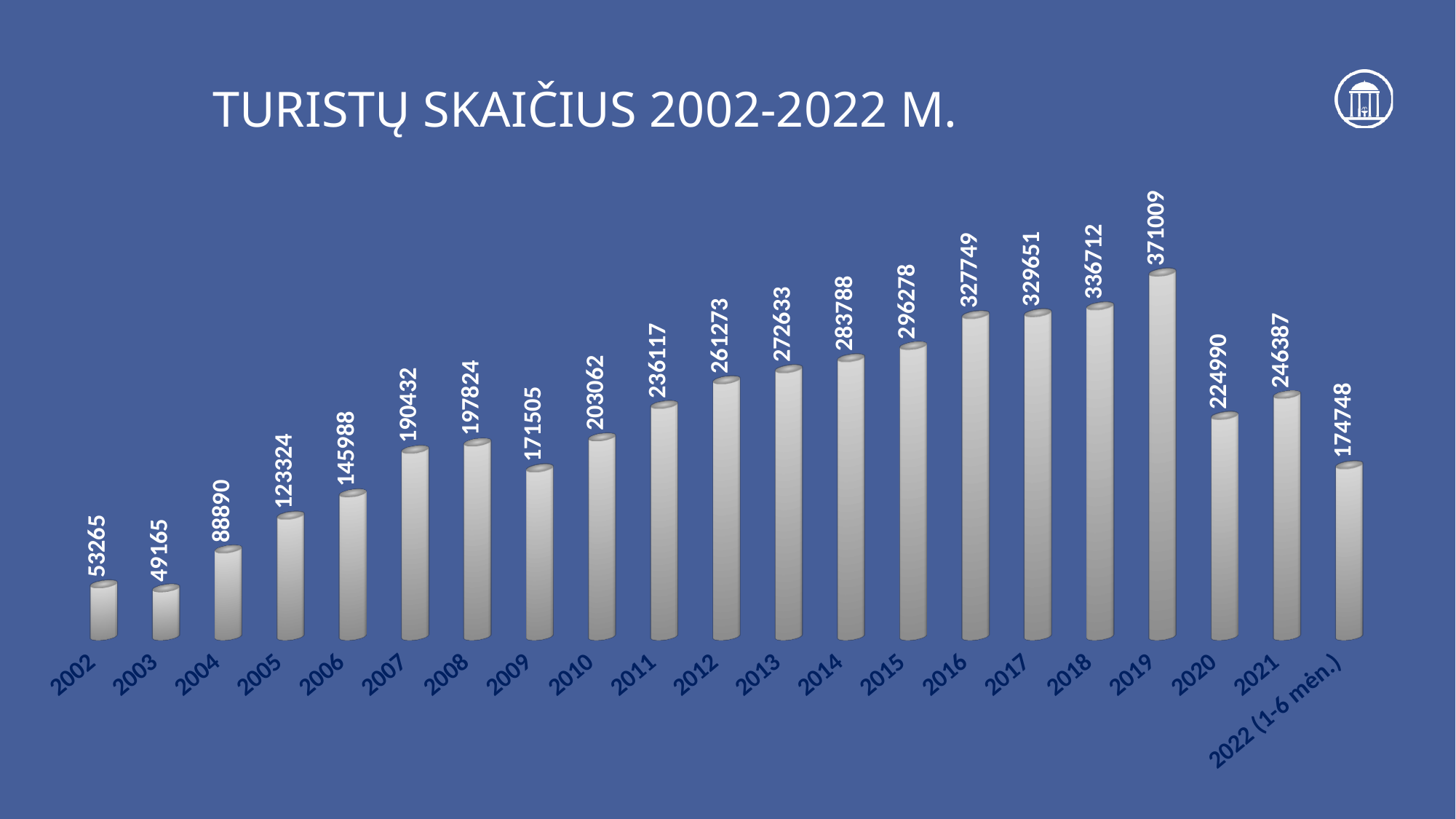
Which year has the lowest value? 2003 What is the value for 2022 (1-6 mėn.)? 174748 What is the difference between the values for 2021 and 2020? 21397 Which year has the highest value? 2019 What is the value for 2002? 53265 What is the value for 2019? 371009 How many categories are shown on the x axis? 21 What is the title of the chart? TURISTŲ SKAIČIUS 2002-2022 M. Which is larger, the value for 2008 or the value for 2009? 2008 What kind of chart is shown on the slide? bar chart What is the value for 2009? 171505 What is the difference between the values for 2019 and 2020? 146019